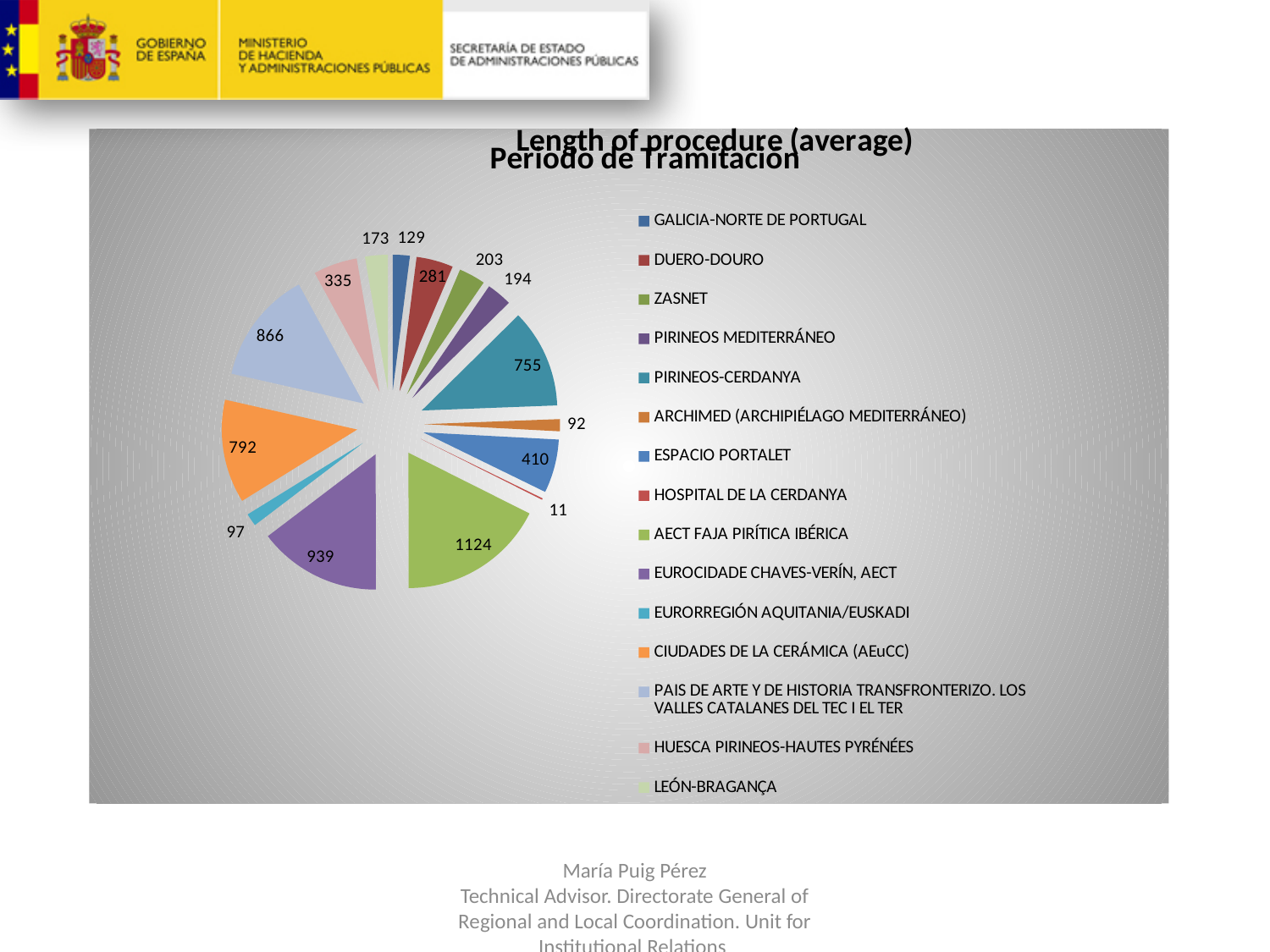
Which category has the smallest slice in the pie chart? HOSPITAL DE LA CERDANYA What is the value shown for AECT FAJA PIRÍTICA IBÉRICA? 1124 What is the value shown for PIRINEOS-CERDANYA? 755 Which is larger, the value for PAIS DE ARTE Y DE HISTORIA TRANSFRONTERIZO or the value for CIUDADES DE LA CERÁMICA (AEuCC)? PAIS DE ARTE Y DE HISTORIA TRANSFRONTERIZO What is the difference between the values for DUERO-DOURO and GALICIA-NORTE DE PORTUGAL? 152 What is the value shown for CIUDADES DE LA CERÁMICA (AEuCC)? 792 What is the value shown for EUROCIDADE CHAVES-VERÍN, AECT? 939 How many entries does the legend of the pie chart list? 15 What is the difference between the values for AECT FAJA PIRÍTICA IBÉRICA and EUROCIDADE CHAVES-VERÍN, AECT? 185 Which category has the largest slice in the pie chart? AECT FAJA PIRÍTICA IBÉRICA What is the English title shown above the pie chart? Length of procedure (average) What kind of chart is shown on the slide? pie chart